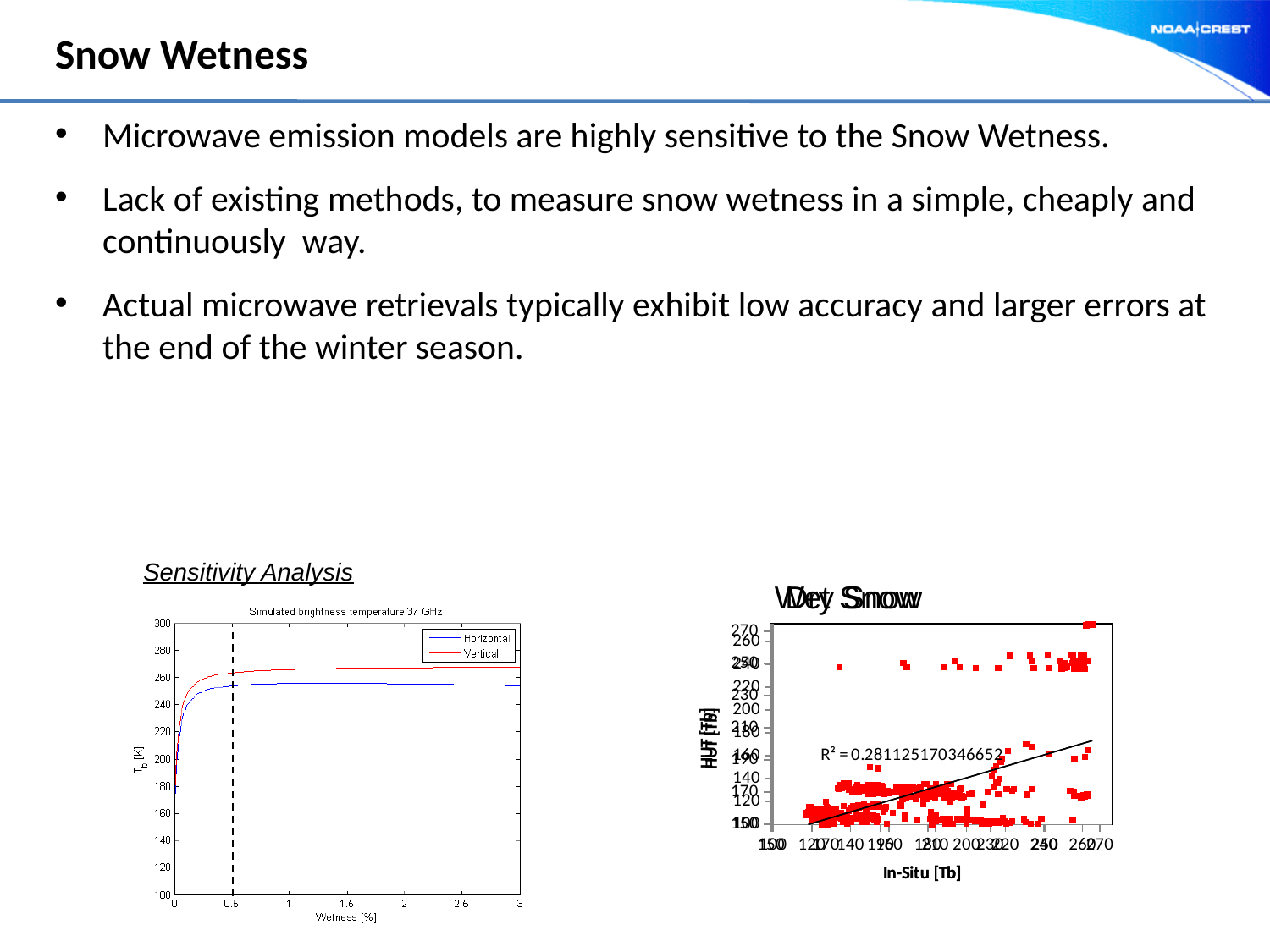
What kind of chart is the chart on the right of the slide (Wet Snow / Dry Snow)? scatter chart On the left chart (Simulated brightness temperature 37 GHz), is the value of the lower curve at Wetness 3% greater or less than 240? greater On the left chart (Simulated brightness temperature 37 GHz), is the value of the lower curve at Wetness 0.1% greater or less than 260? less On the left chart (Simulated brightness temperature 37 GHz), do the curves rise or fall as Wetness [%] increases? rise What kind of chart is the Sensitivity Analysis chart on the left? line chart What R² value is printed on the right-hand scatter chart? R² = 0.281125170346652 On the right-hand scatter chart, does the fitted trend line rise or fall as In-Situ [Tb] increases? rise How many series does the legend of the left chart (Simulated brightness temperature 37 GHz) list? 2 What is the title of the left chart under Sensitivity Analysis? Simulated brightness temperature 37 GHz On the left chart (Simulated brightness temperature 37 GHz), is the value of the upper curve at Wetness 2% greater or less than 240? greater What are the two legend entries on the left chart (Simulated brightness temperature 37 GHz)? Horizontal and Vertical